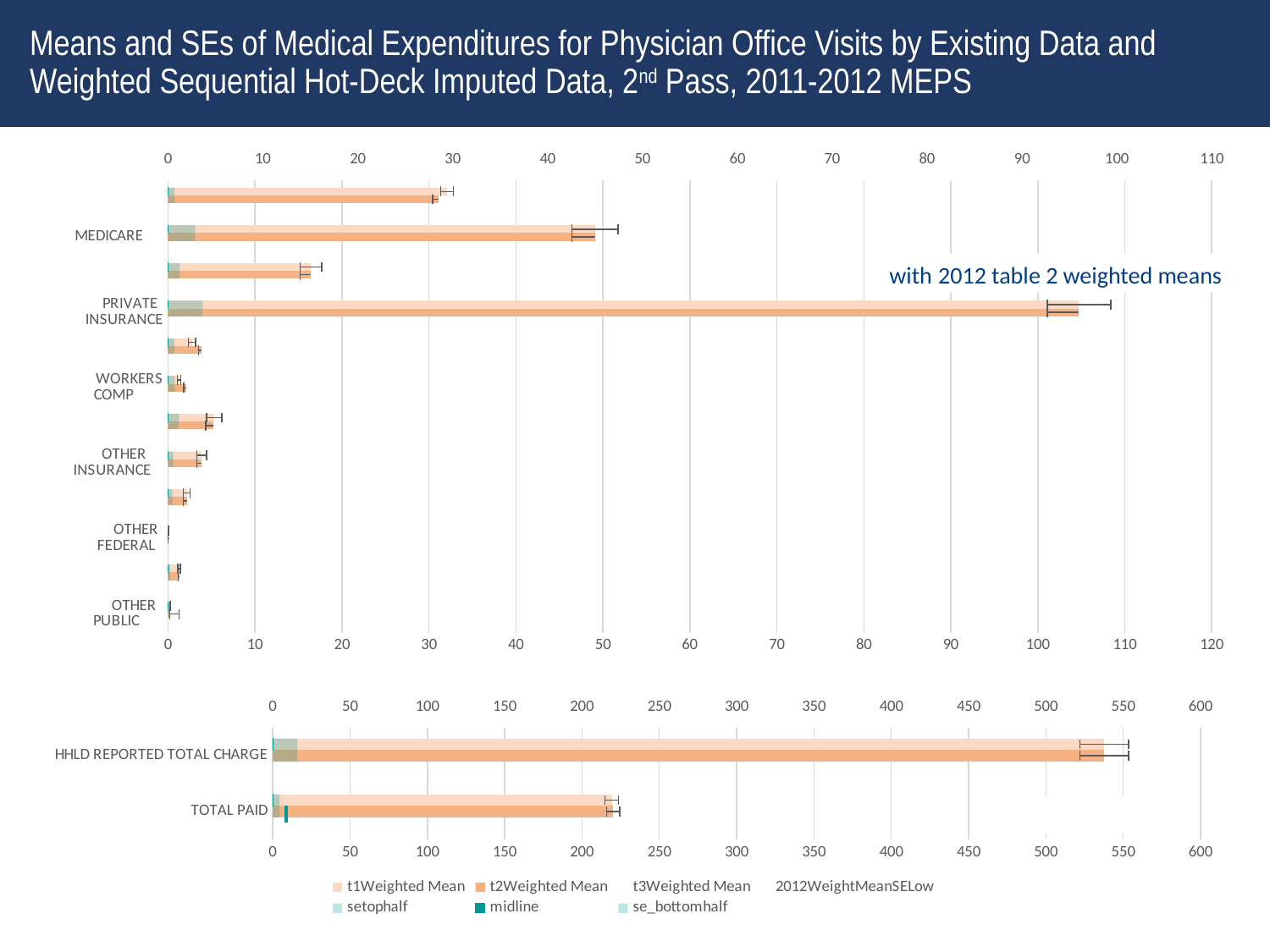
What is the highest value shown on the horizontal axis of the bottom chart? 600 In the top chart, is the longest bar for MEDICARE greater or less than 40? greater How many labeled categories are shown on the vertical axis of the top chart? 6 What kind of chart is the top chart on the slide? bar chart How many categories are shown in the bottom chart? 2 In the bottom chart, which category has the longer bar, HHLD REPORTED TOTAL CHARGE or TOTAL PAID? HHLD REPORTED TOTAL CHARGE In the top chart, which labeled category has the longest bar? PRIVATE INSURANCE How many series does the legend at the bottom of the slide list? 7 In the bottom chart, is the bar for HHLD REPORTED TOTAL CHARGE greater or less than 500? greater In the bottom chart, is the bar for TOTAL PAID greater or less than 250? less